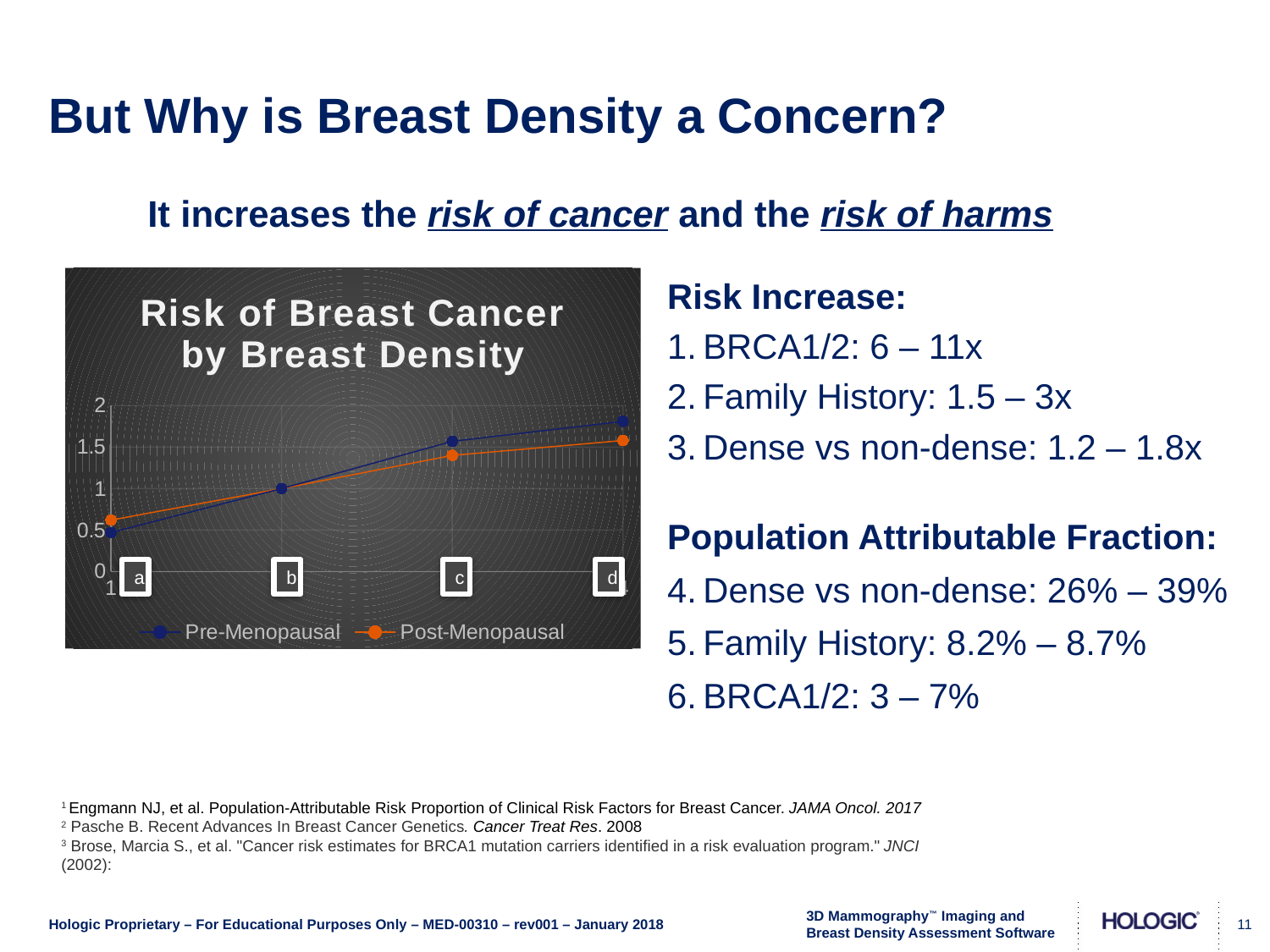
Which category has the highest Pre-Menopausal value? d Do the Pre-Menopausal values rise or fall from category a to category d? rise What are the two series named in the chart legend? Pre-Menopausal and Post-Menopausal How many categories are shown along the x axis of the chart? 4 Do the Post-Menopausal values rise or fall from category a to category d? rise At category d, which series has the larger value, Pre-Menopausal or Post-Menopausal? Pre-Menopausal What kind of chart is shown on the slide? line chart How many series does the chart legend list? 2 Is the Post-Menopausal value for category a greater or less than 1? less Is the Pre-Menopausal value for category d greater or less than 1.5? greater What is the title of the chart? Risk of Breast Cancer by Breast Density Which category has the lowest Post-Menopausal value? a